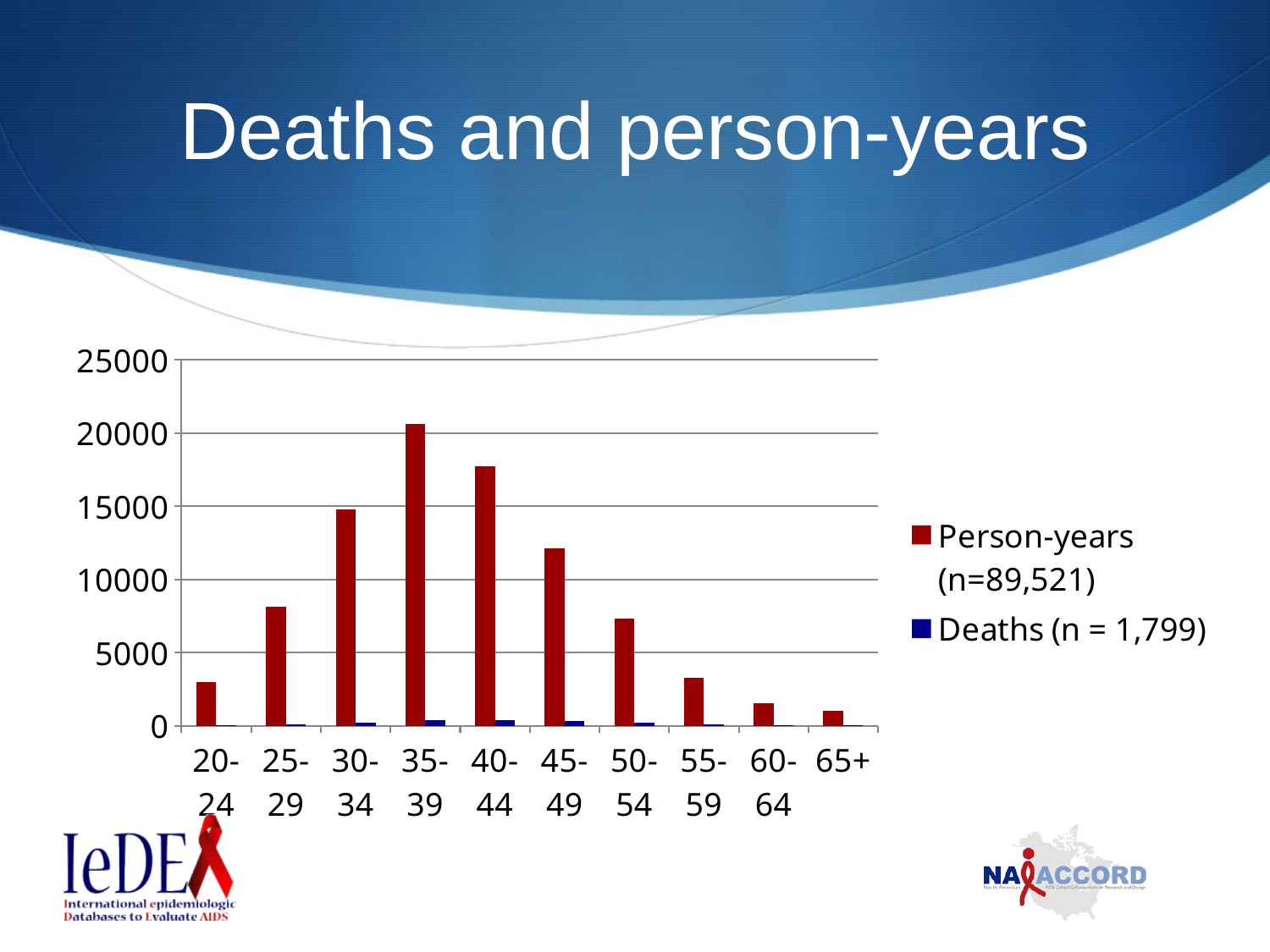
Which age group has the lowest number of person-years? 65+ Do the person-years values rise or fall across the age groups from 35-39 to 65+? fall Is the person-years value for the 45-49 age group greater or less than 10000? greater What kind of chart is shown on the slide? bar chart How many series does the chart's legend list? 2 Is the person-years value for the 25-29 age group greater or less than 10000? less Which age group has more person-years, 30-34 or 40-44? 40-44 What total is given in the legend for the Person-years series? 89,521 Is the person-years value for the 35-39 age group greater or less than 20000? greater What total number of deaths is given in the legend for the Deaths series? 1,799 Which age group has the highest number of person-years? 35-39 How many age groups are shown on the x axis of the chart? 10